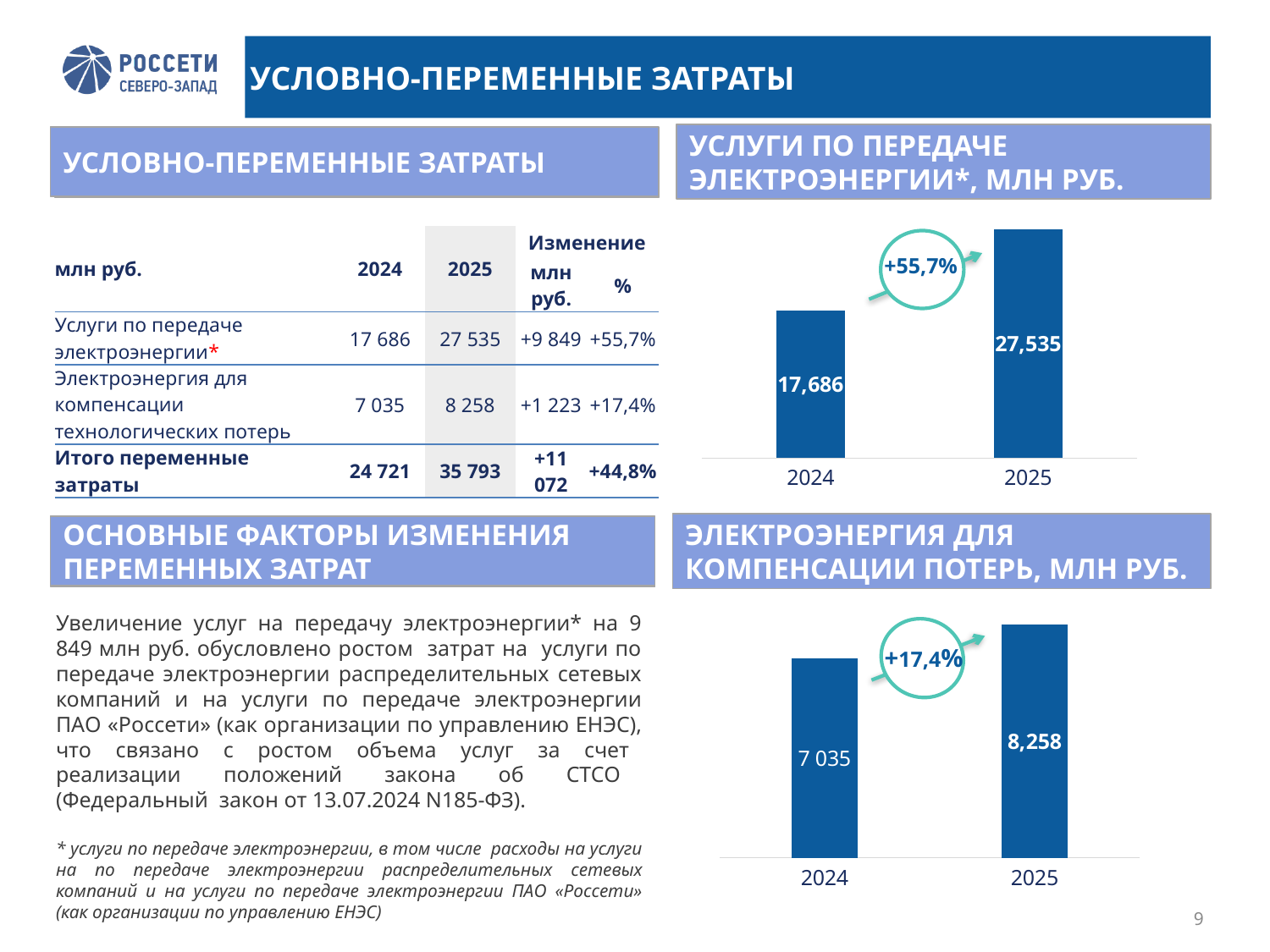
In the chart titled 'ЭЛЕКТРОЭНЕРГИЯ ДЛЯ КОМПЕНСАЦИИ ПОТЕРЬ, МЛН РУБ.', what is the value for 2024? 7 035 In the chart titled 'ЭЛЕКТРОЭНЕРГИЯ ДЛЯ КОМПЕНСАЦИИ ПОТЕРЬ, МЛН РУБ.', what percentage change is shown between 2024 and 2025? +17,4% In the chart titled 'ЭЛЕКТРОЭНЕРГИЯ ДЛЯ КОМПЕНСАЦИИ ПОТЕРЬ, МЛН РУБ.', do the values rise or fall from 2024 to 2025? Rise In the chart titled 'УСЛУГИ ПО ПЕРЕДАЧЕ ЭЛЕКТРОЭНЕРГИИ*, МЛН РУБ.', what is the value for 2024? 17,686 In the chart titled 'УСЛУГИ ПО ПЕРЕДАЧЕ ЭЛЕКТРОЭНЕРГИИ*, МЛН РУБ.', what percentage change is shown between 2024 and 2025? +55,7% In the chart titled 'УСЛУГИ ПО ПЕРЕДАЧЕ ЭЛЕКТРОЭНЕРГИИ*, МЛН РУБ.', what is the value for 2025? 27,535 In the chart titled 'УСЛУГИ ПО ПЕРЕДАЧЕ ЭЛЕКТРОЭНЕРГИИ*, МЛН РУБ.', how many bars are plotted? 2 In the chart titled 'УСЛУГИ ПО ПЕРЕДАЧЕ ЭЛЕКТРОЭНЕРГИИ*, МЛН РУБ.', what is the difference between the 2025 and 2024 values? 9,849 In the chart titled 'УСЛУГИ ПО ПЕРЕДАЧЕ ЭЛЕКТРОЭНЕРГИИ*, МЛН РУБ.', which year has the higher value? 2025 What kind of chart is the one titled 'ЭЛЕКТРОЭНЕРГИЯ ДЛЯ КОМПЕНСАЦИИ ПОТЕРЬ, МЛН РУБ.'? Bar chart In the chart titled 'ЭЛЕКТРОЭНЕРГИЯ ДЛЯ КОМПЕНСАЦИИ ПОТЕРЬ, МЛН РУБ.', what is the value for 2025? 8,258 In the chart titled 'ЭЛЕКТРОЭНЕРГИЯ ДЛЯ КОМПЕНСАЦИИ ПОТЕРЬ, МЛН РУБ.', which year has the lower value? 2024